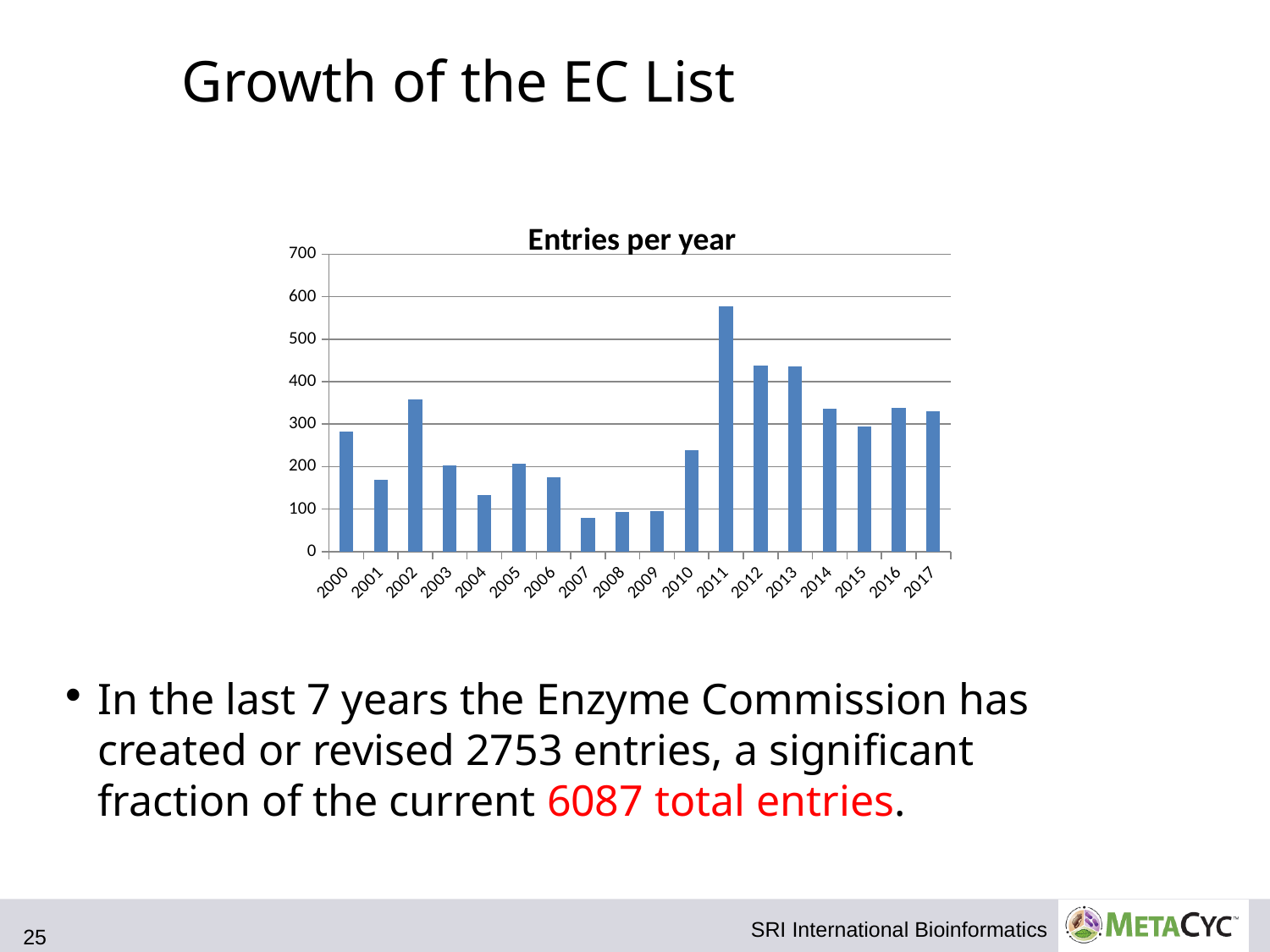
Which year has more entries, 2011 or 2012? 2011 Which year has the highest number of entries? 2011 Which year has the lowest number of entries? 2007 Is the value for 2011 greater or less than 500? greater Is the value for 2007 greater or less than 100? less Is the value for 2002 greater or less than 300? greater How many years are shown on the x axis of the chart? 18 What is the title of the chart? Entries per year Do the values generally rise or fall from 2007 to 2011? rise Which year has more entries, 2000 or 2001? 2000 What kind of chart is shown on the slide? Bar chart